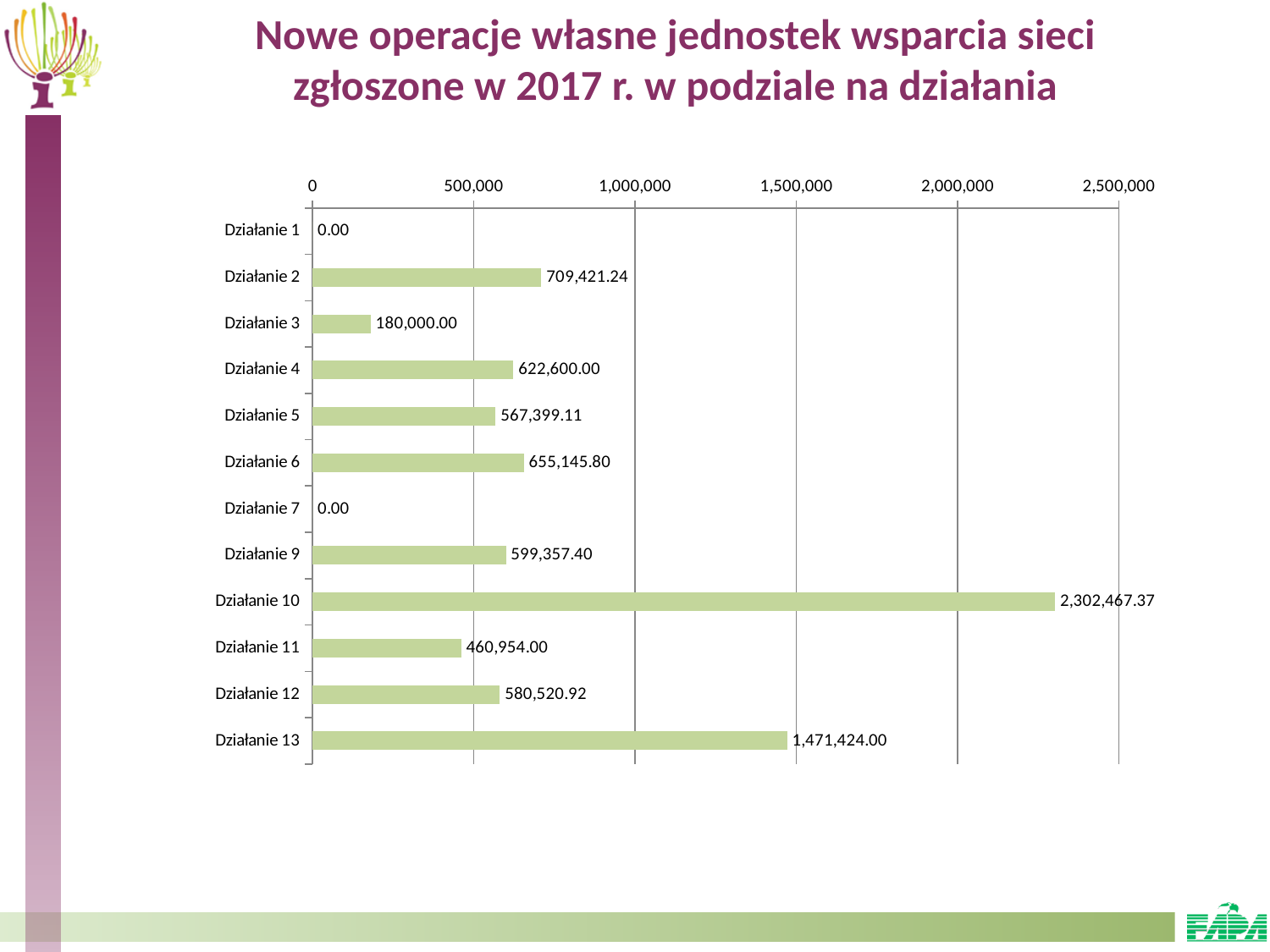
Which is larger, the value for Działanie 5 or the value for Działanie 12? Działanie 12 What is the value for Działanie 12? 580,520.92 What kind of chart is shown on the slide? bar chart How many categories have a value of 0.00? 2 Which category has the lowest non-zero value? Działanie 3 How many categories are shown on the chart? 12 What is the value for Działanie 3? 180,000.00 What is the value for Działanie 10? 2,302,467.37 What is the difference between the values for Działanie 10 and Działanie 13? 831,043.37 What is the difference between the values for Działanie 2 and Działanie 6? 54,275.44 Which category has the highest value? Działanie 10 Is the value for Działanie 13 greater or less than 1,000,000? greater